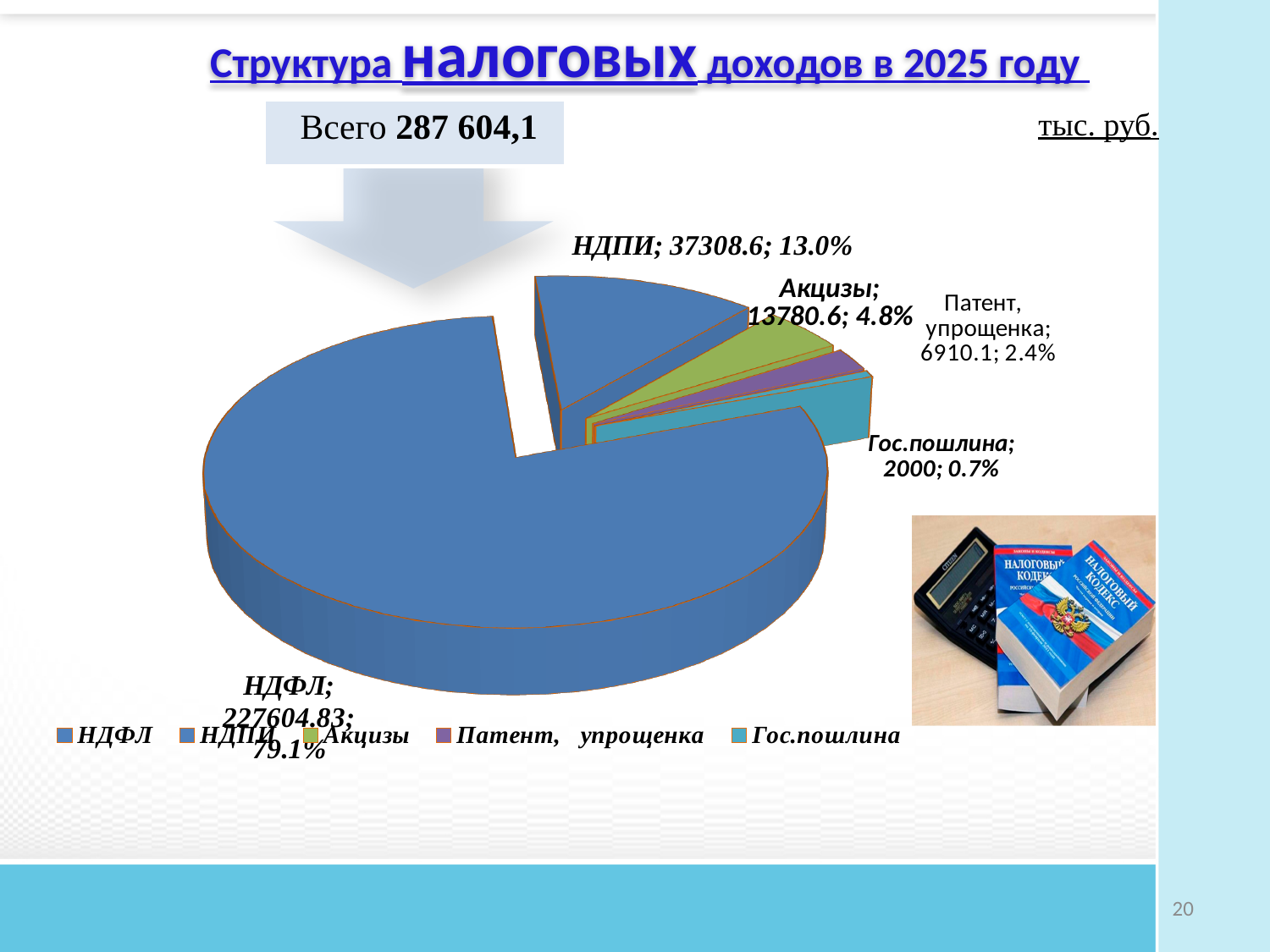
What share of the pie does Акцизы represent? 4.8% What is the difference between the values for Акцизы and Патент, упрощенка? 6870.5 What kind of chart is shown on the slide? pie chart What total amount is shown above the pie chart? 287 604,1 How many categories does the pie chart have? 5 Which category has the largest slice of the pie? НДФЛ What is the value for Патент, упрощенка? 6910.1 Which is larger, the value for НДПИ or the value for Акцизы? НДПИ What is the value for НДПИ in the pie chart? 37308.6 What is the value for Гос.пошлина? 2000 What percentage of the pie is НДФЛ? 79.1% Which category has the smallest slice of the pie? Гос.пошлина